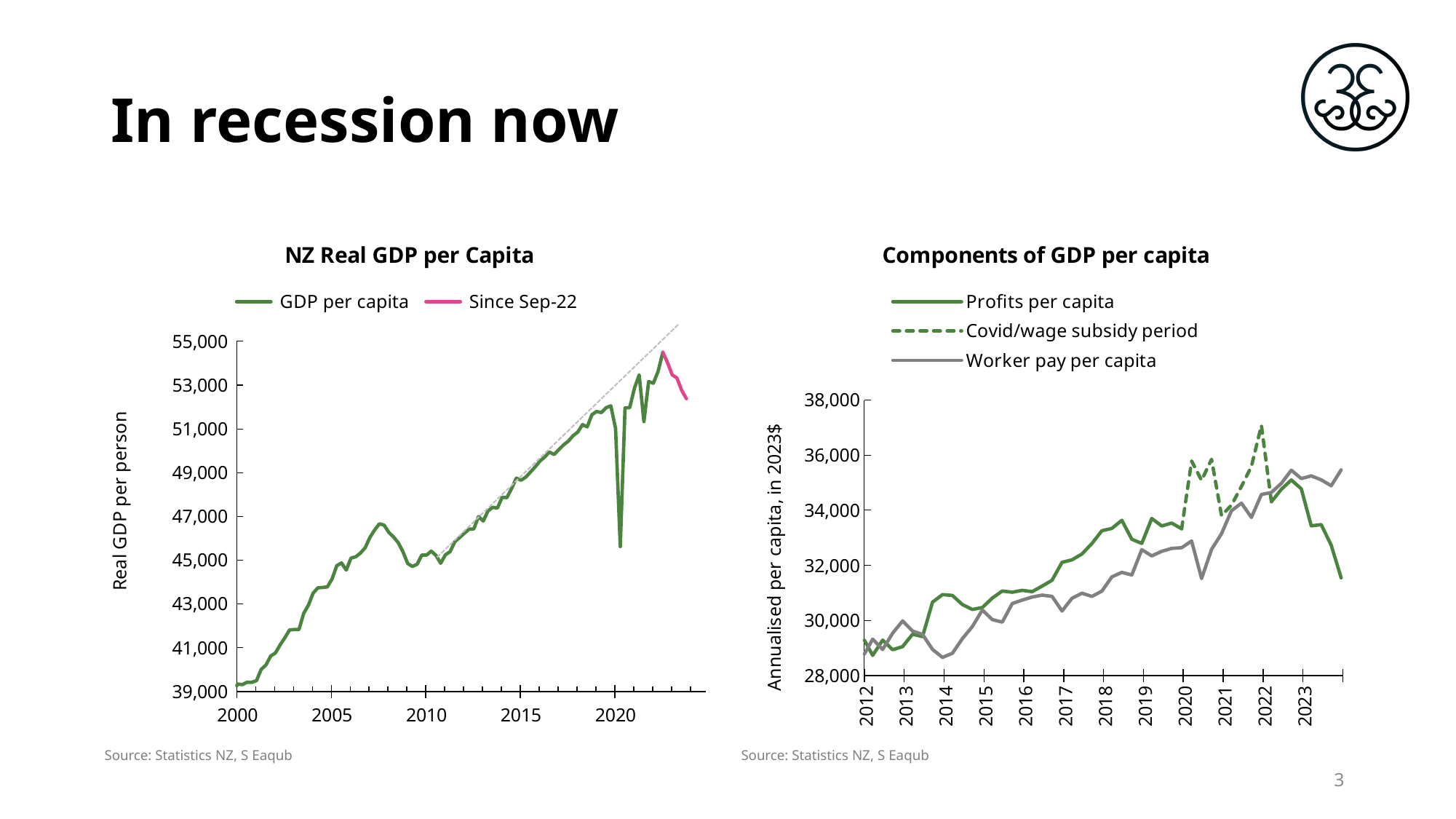
In the 'Components of GDP per capita' chart, is the value for Profits per capita in 2012 greater or less than 30,000? less What is the y-axis label of the 'NZ Real GDP per Capita' chart? Real GDP per person What kind of chart is the 'Components of GDP per capita' chart? line chart What kind of chart is the 'NZ Real GDP per Capita' chart? line chart How many series does the legend of the 'NZ Real GDP per Capita' chart list? 2 In the 'NZ Real GDP per Capita' chart, does real GDP per capita generally rise or fall from 2000 to 2020? rise In the 'Components of GDP per capita' chart, is the peak of the Covid/wage subsidy period line around 2022 greater or less than 36,000? greater In the 'NZ Real GDP per Capita' chart, is the lowest point of the sharp dip around 2020 greater or less than 47,000? less In the 'Components of GDP per capita' chart, at the end of 2023, which is higher: Profits per capita or Worker pay per capita? Worker pay per capita What is the y-axis label of the 'Components of GDP per capita' chart? Annualised per capita, in 2023$ How many series does the legend of the 'Components of GDP per capita' chart list? 3